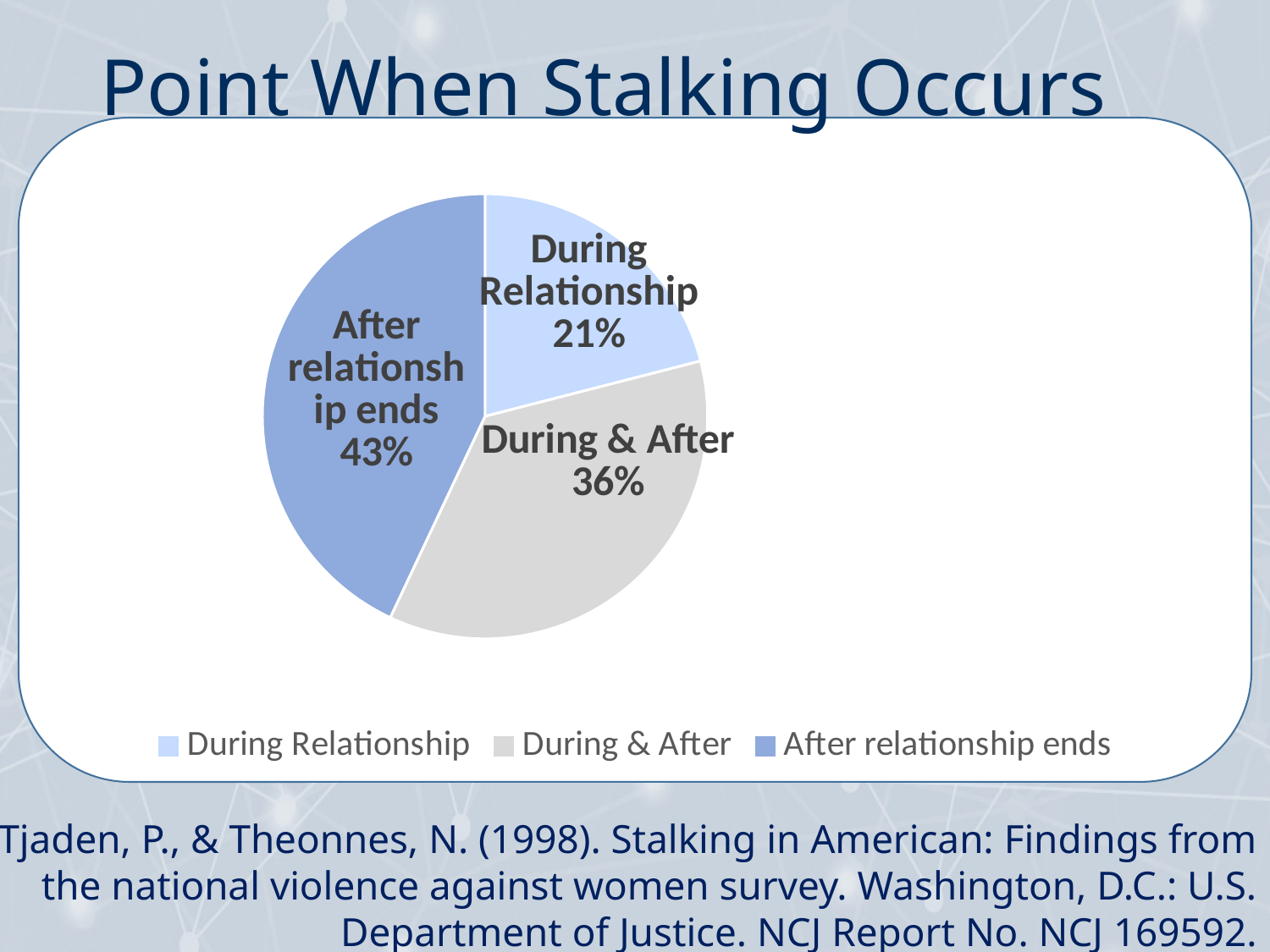
What is the difference in percentage points between 'After relationship ends' and 'During Relationship'? 22 Which category has the largest share of the pie? After relationship ends What is the title of the slide containing the pie chart? Point When Stalking Occurs What kind of chart is shown on the slide? pie chart What percentage of stalking occurs during and after the relationship? 36% Which is larger, the share for 'During & After' or the share for 'During Relationship'? During & After What percentage of stalking occurs during the relationship? 21% What percentage of stalking occurs after the relationship ends? 43% How many entries does the legend list? 3 What is the difference in percentage points between 'After relationship ends' and 'During & After'? 7 How many slices does the pie chart have? 3 Which category has the smallest share of the pie? During Relationship